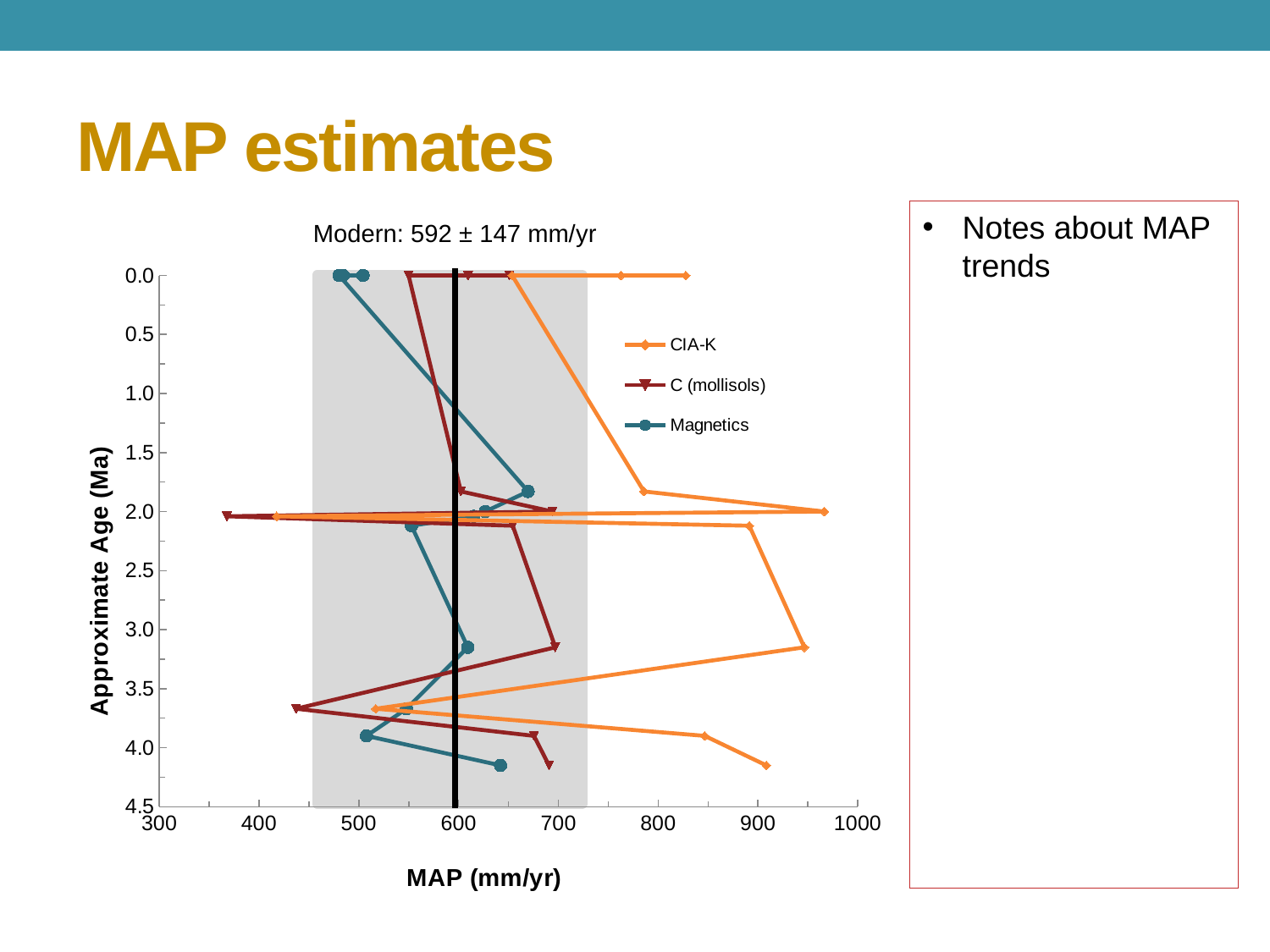
Is the Magnetics value at about 4.15 Ma greater or less than 600? greater At 0.0 Ma, which series has the larger MAP value, CIA-K or Magnetics? CIA-K How many series does the chart legend list? 3 Is the C (mollisols) value at about 2.0 Ma (its leftmost point) greater or less than 400? less Is the CIA-K value at 2.0 Ma greater or less than 900? greater Which series reaches the highest MAP value on the chart? CIA-K What modern MAP value is stated above the chart? 592 ± 147 mm/yr What is the label of the x axis of the chart? MAP (mm/yr) What kind of chart is shown on the slide? Line chart